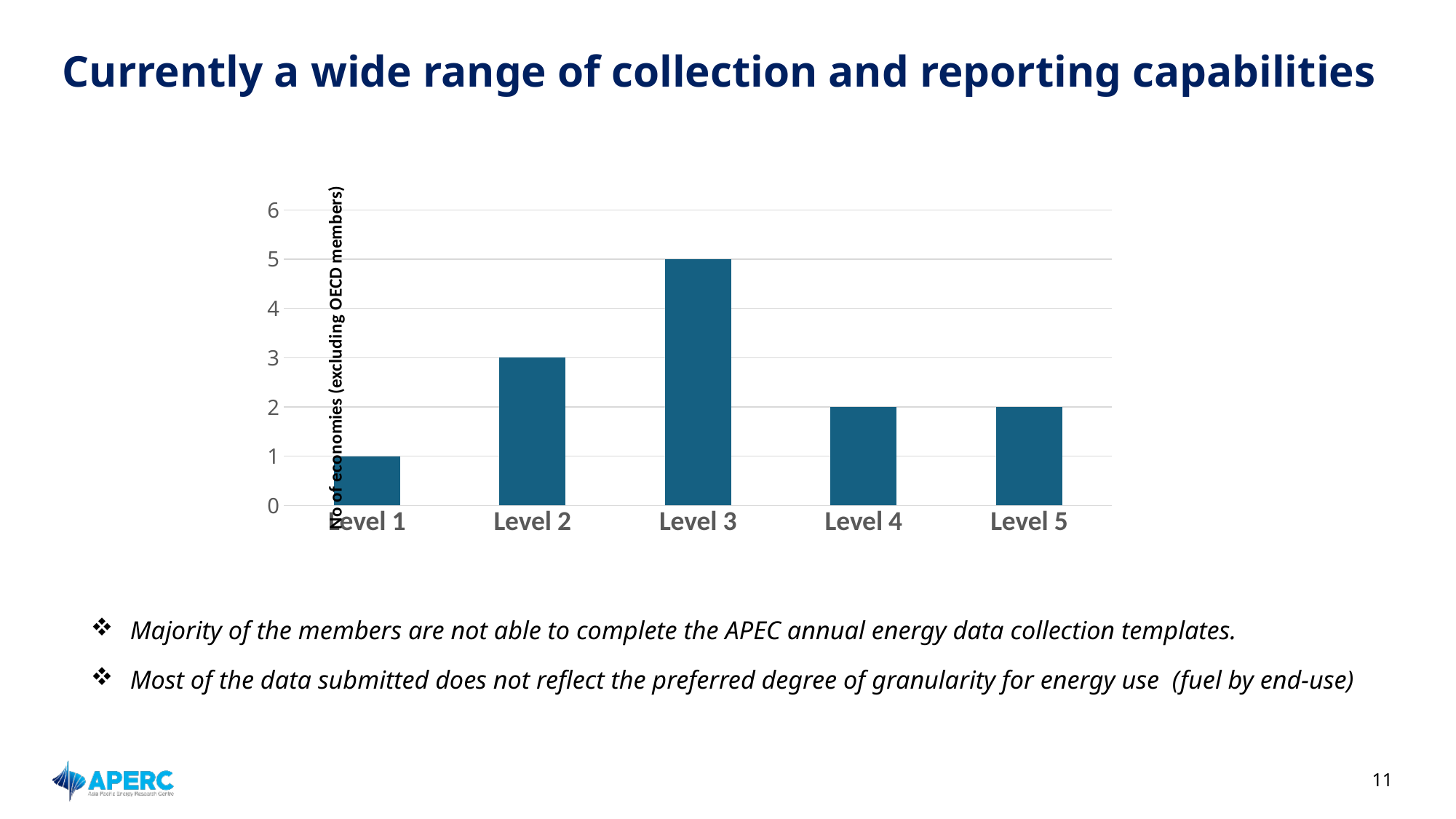
What is the label of the vertical axis? No of economies (excluding OECD members) Which is larger, the value for Level 2 or the value for Level 4? Level 2 What kind of chart is shown on the slide? bar chart Is the value for Level 3 greater or less than 4? greater Which level has the highest number of economies? Level 3 What is the value for Level 2? 3 Which level has the lowest number of economies? Level 1 What is the difference between the values for Level 3 and Level 2? 2 What is the value for Level 1? 1 What is the difference between the values for Level 2 and Level 1? 2 How many levels are shown on the x axis? 5 What is the value for Level 3? 5